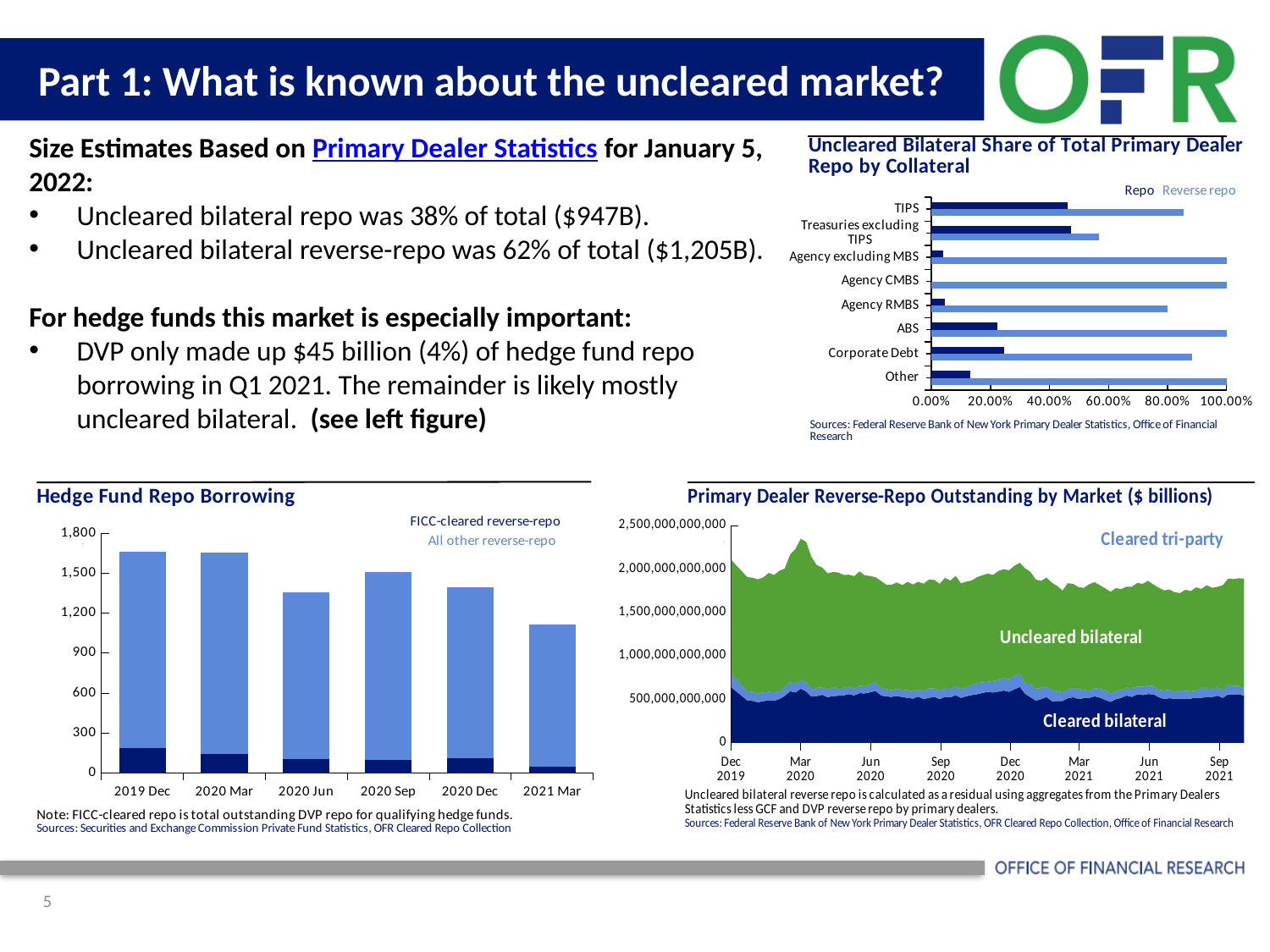
How many series does the legend of the 'Hedge Fund Repo Borrowing' chart list? 2 How many time periods are shown on the x axis of the 'Hedge Fund Repo Borrowing' chart? 6 In the 'Hedge Fund Repo Borrowing' chart, is the total bar for 2021 Mar greater or less than 1,200? less In the 'Uncleared Bilateral Share of Total Primary Dealer Repo by Collateral' chart, is the Reverse repo share for Treasuries excluding TIPS greater or less than 80.00%? less In the 'Hedge Fund Repo Borrowing' chart, which period has the lowest total bar? 2021 Mar In the 'Uncleared Bilateral Share of Total Primary Dealer Repo by Collateral' chart, which collateral category has the lowest Repo share? Agency CMBS How many series does the legend of the 'Uncleared Bilateral Share of Total Primary Dealer Repo by Collateral' chart list? 2 What type of chart is 'Uncleared Bilateral Share of Total Primary Dealer Repo by Collateral'? Bar chart In the 'Uncleared Bilateral Share of Total Primary Dealer Repo by Collateral' chart, which is larger for Reverse repo: TIPS or Treasuries excluding TIPS? TIPS How many market segments are labelled in the 'Primary Dealer Reverse-Repo Outstanding by Market ($ billions)' chart? 3 How many collateral categories are shown in the 'Uncleared Bilateral Share of Total Primary Dealer Repo by Collateral' chart? 8 In the 'Uncleared Bilateral Share of Total Primary Dealer Repo by Collateral' chart, is the Repo share for TIPS greater or less than 40.00%? greater